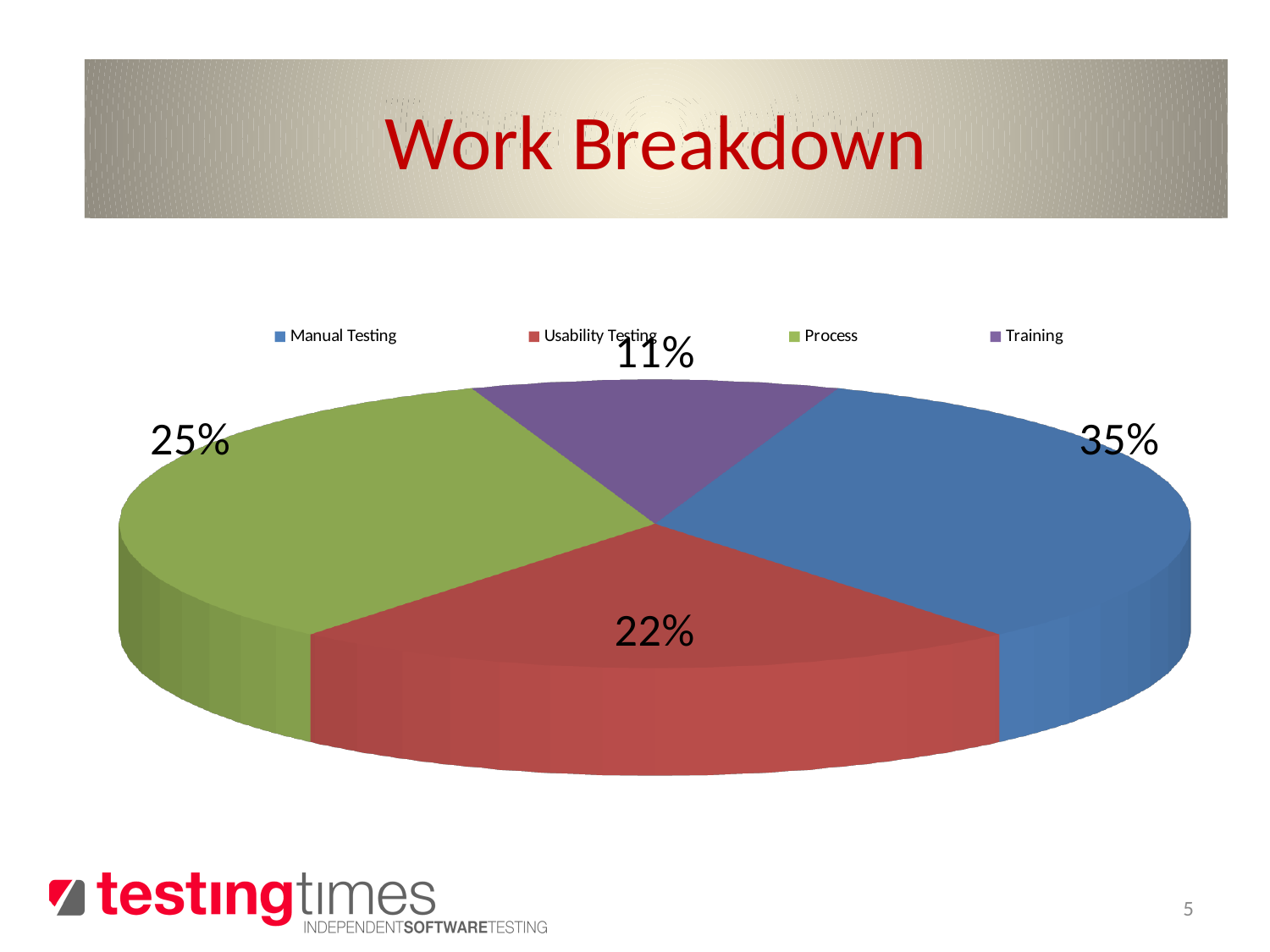
What kind of chart is shown on the slide? Pie chart Which category has the smallest share of the pie? Training What is the title of the chart on the slide? Work Breakdown What is the difference in percentage points between Process and Usability Testing? 3 Which category has the largest share of the pie? Manual Testing What share of the pie does Training represent? 11% What share of the pie does Manual Testing represent? 35% Which is larger, the share for Process or the share for Usability Testing? Process How many categories are shown in the pie chart? 4 What share of the pie does Process represent? 25% What share of the pie does Usability Testing represent? 22% What is the difference in percentage points between Manual Testing and Training? 24